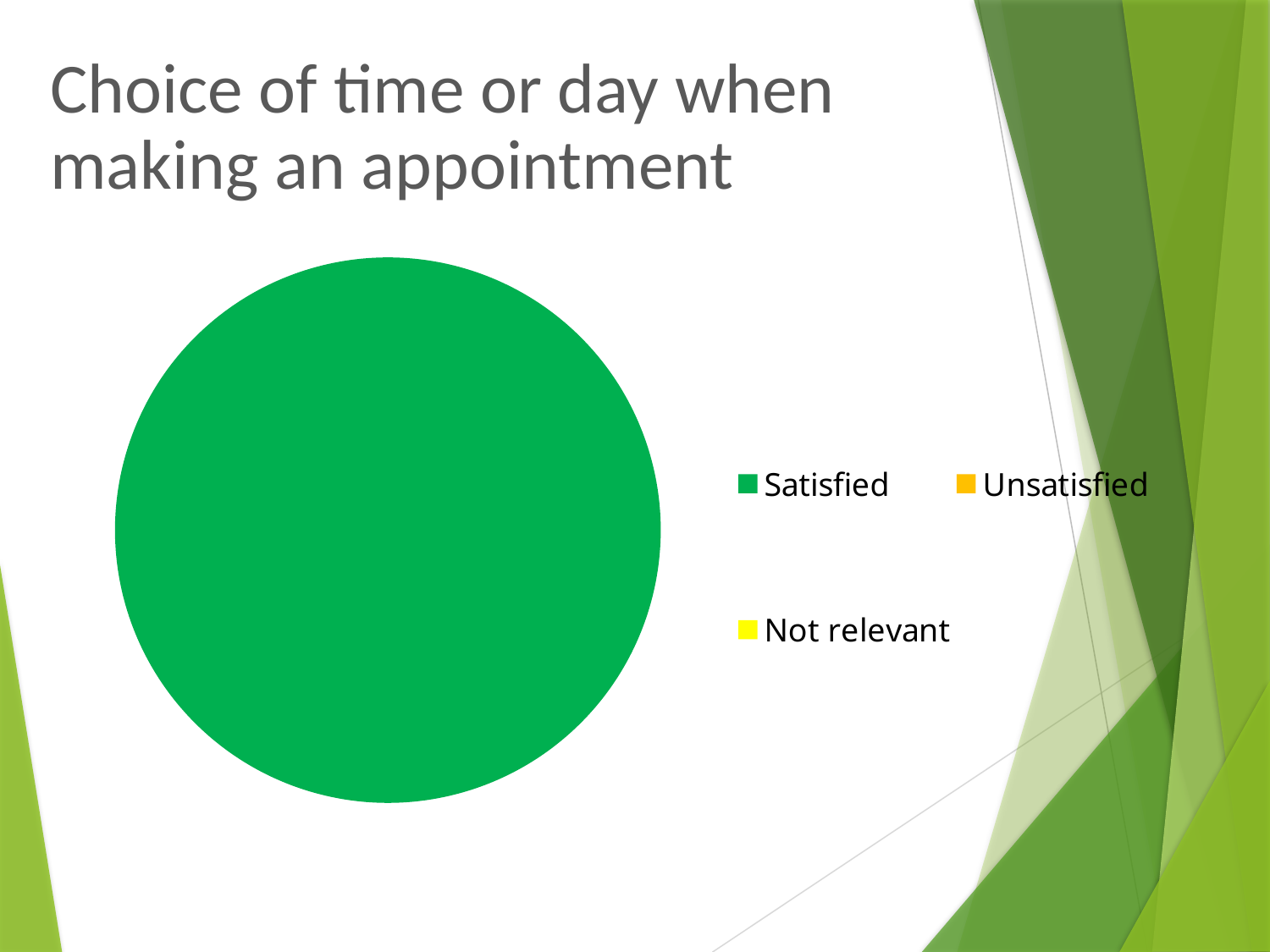
Which category takes up the largest share of the pie? Satisfied What is the title of the slide containing the pie chart? Choice of time or day when making an appointment What kind of chart is shown on the slide? pie chart How many categories does the legend list? 3 Which is larger in the pie, Satisfied or Not relevant? Satisfied Which is larger in the pie, Satisfied or Unsatisfied? Satisfied Which legend entry is shown in green? Satisfied